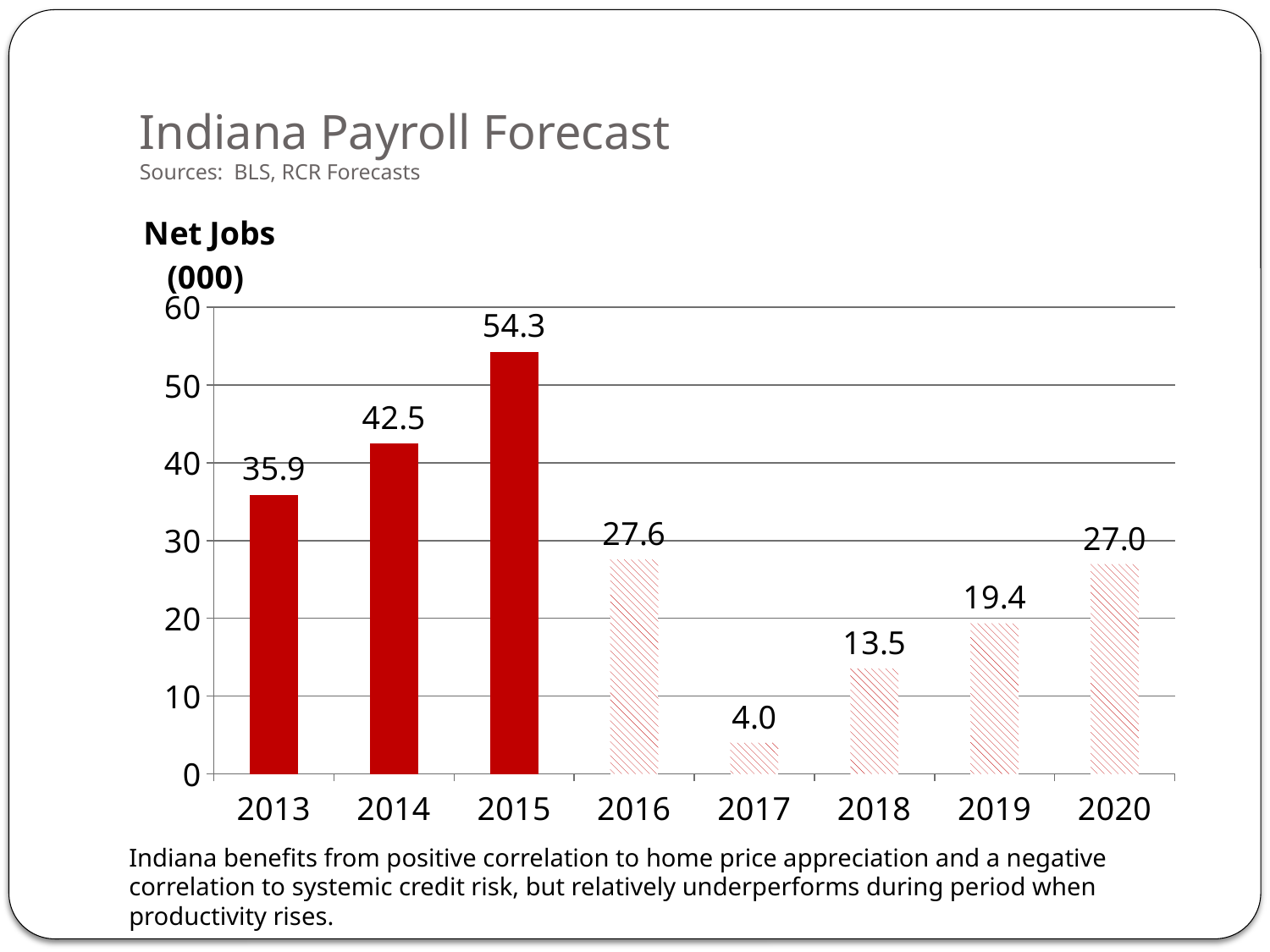
What is the value for 2017? 4.0 What is the difference between the values for 2015 and 2014? 11.8 Which year has the lowest value? 2017 What is the value for 2020? 27.0 What is the difference between the values for 2016 and 2017? 23.6 What is the title of the slide's chart? Indiana Payroll Forecast How many years are shown on the x axis? 8 What is the value for 2015? 54.3 What kind of chart is shown on the slide? bar chart Is the value for 2013 greater or less than 30? greater Which is larger, the value for 2018 or the value for 2019? 2019 Which year has the highest value? 2015